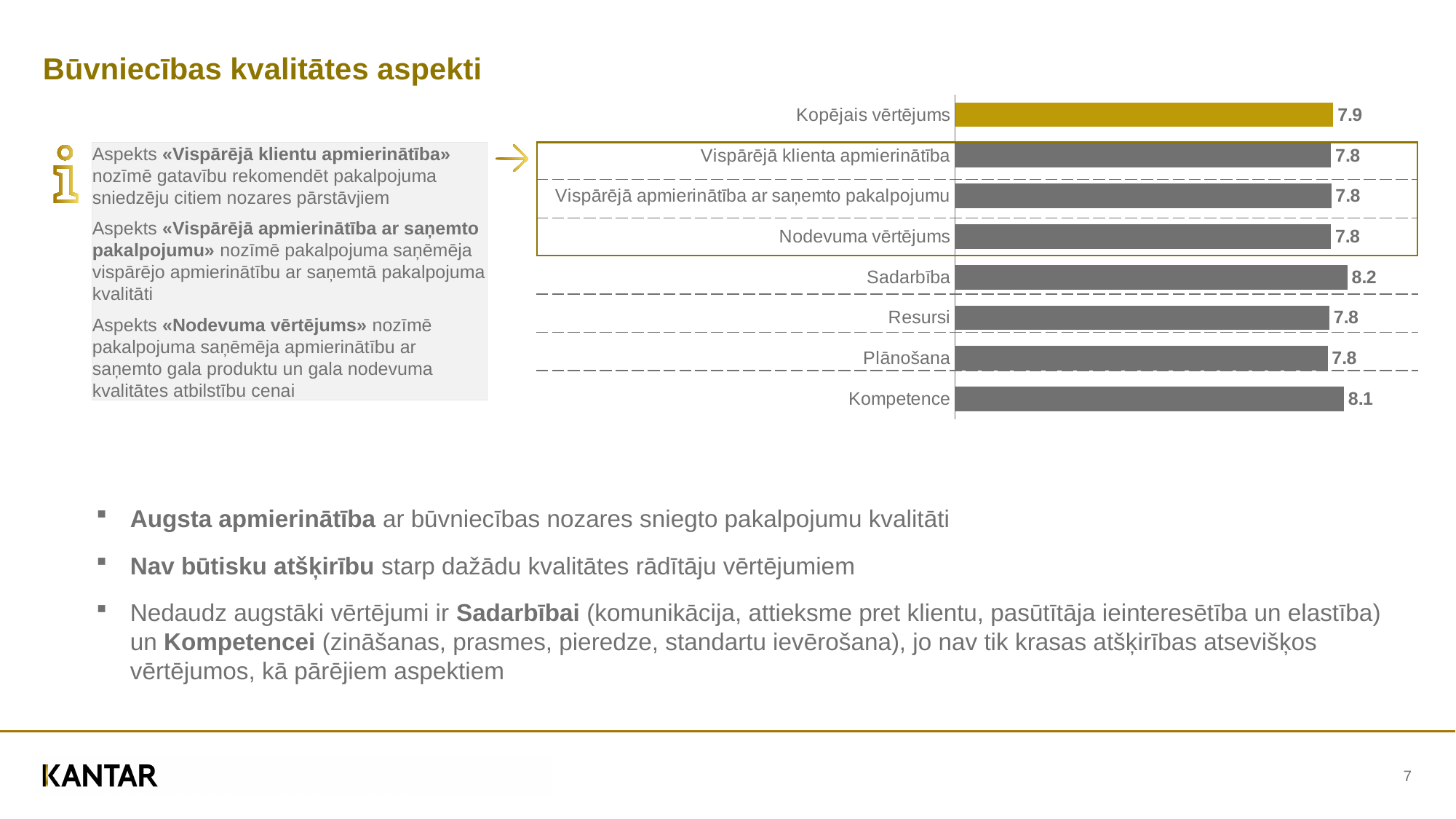
Which category has the highest value? Sadarbība What is the value for Sadarbība? 8.2 What is the value for Plānošana? 7.8 What kind of chart is shown on the slide? Bar chart Which has a larger value, Sadarbība or Kompetence? Sadarbība What is the value for Kopējais vērtējums? 7.9 What is the difference between the values for Kompetence and Kopējais vērtējums? 0.2 How many categories are shown in the chart? 8 What is the difference between the values for Sadarbība and Resursi? 0.4 What is the value for Kompetence? 8.1 What is the value for Nodevuma vērtējums? 7.8 Which category's bar is coloured gold rather than grey? Kopējais vērtējums